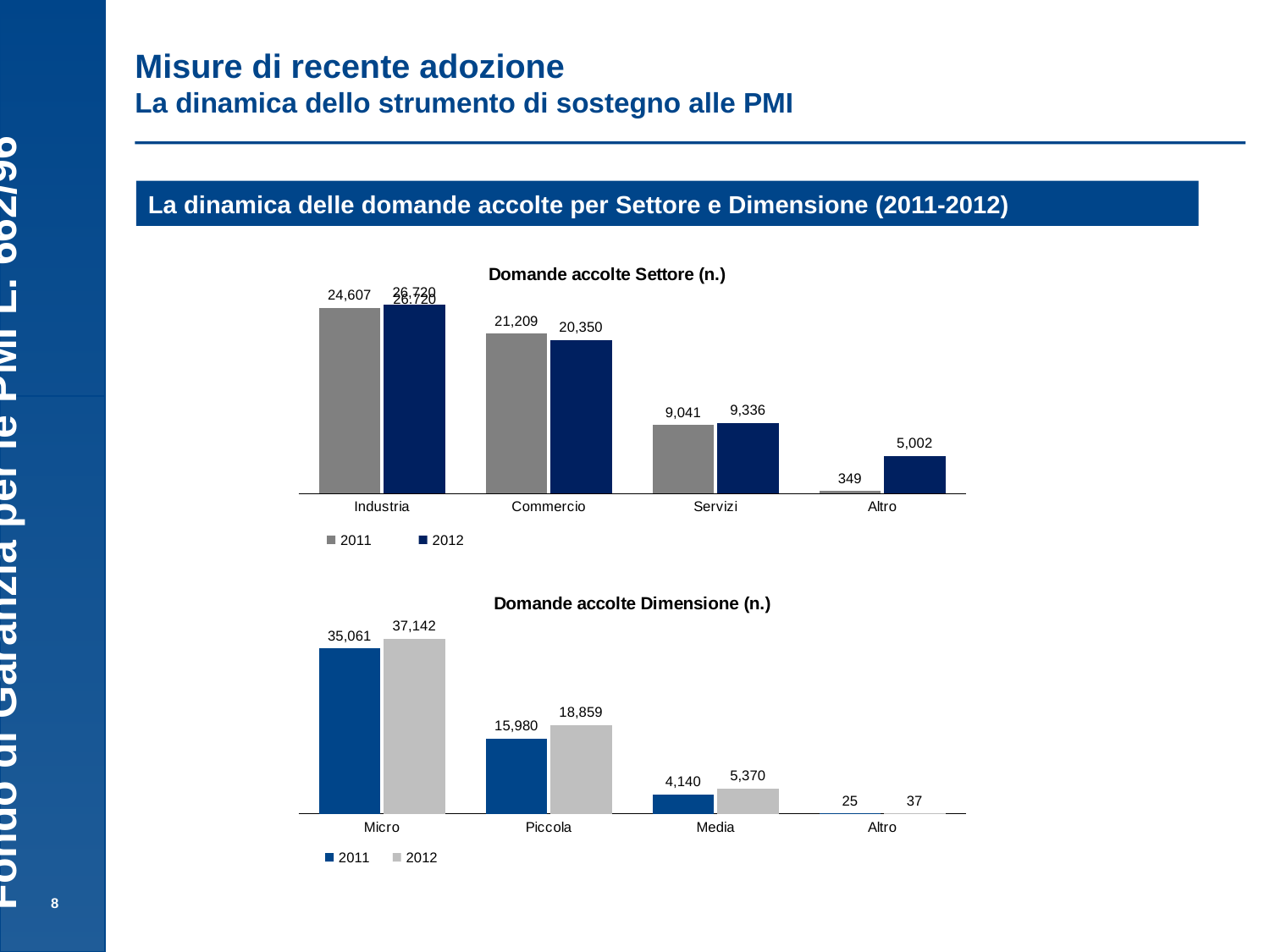
In the 'Domande accolte Dimensione (n.)' chart, what is the value for Media in 2011? 4,140 In the 'Domande accolte Settore (n.)' chart, what is the difference between the 2012 and 2011 values for Servizi? 295 In the 'Domande accolte Settore (n.)' chart, how many series does the legend list? 2 In the 'Domande accolte Settore (n.)' chart, is the 2011 value for Commercio larger or smaller than the 2012 value for Commercio? larger In the 'Domande accolte Dimensione (n.)' chart, how many categories are shown on the x axis? 4 What type of chart is the 'Domande accolte Dimensione (n.)' chart? Bar chart In the 'Domande accolte Settore (n.)' chart, which category has the lowest value for 2011? Altro In the 'Domande accolte Settore (n.)' chart, what is the value for Altro in 2012? 5,002 In the 'Domande accolte Dimensione (n.)' chart, which category has the highest value for 2012? Micro In the 'Domande accolte Settore (n.)' chart, what is the value for Commercio in 2011? 21,209 In the 'Domande accolte Dimensione (n.)' chart, what is the value for Piccola in 2012? 18,859 In the 'Domande accolte Dimensione (n.)' chart, what is the difference between the 2012 and 2011 values for Micro? 2,081